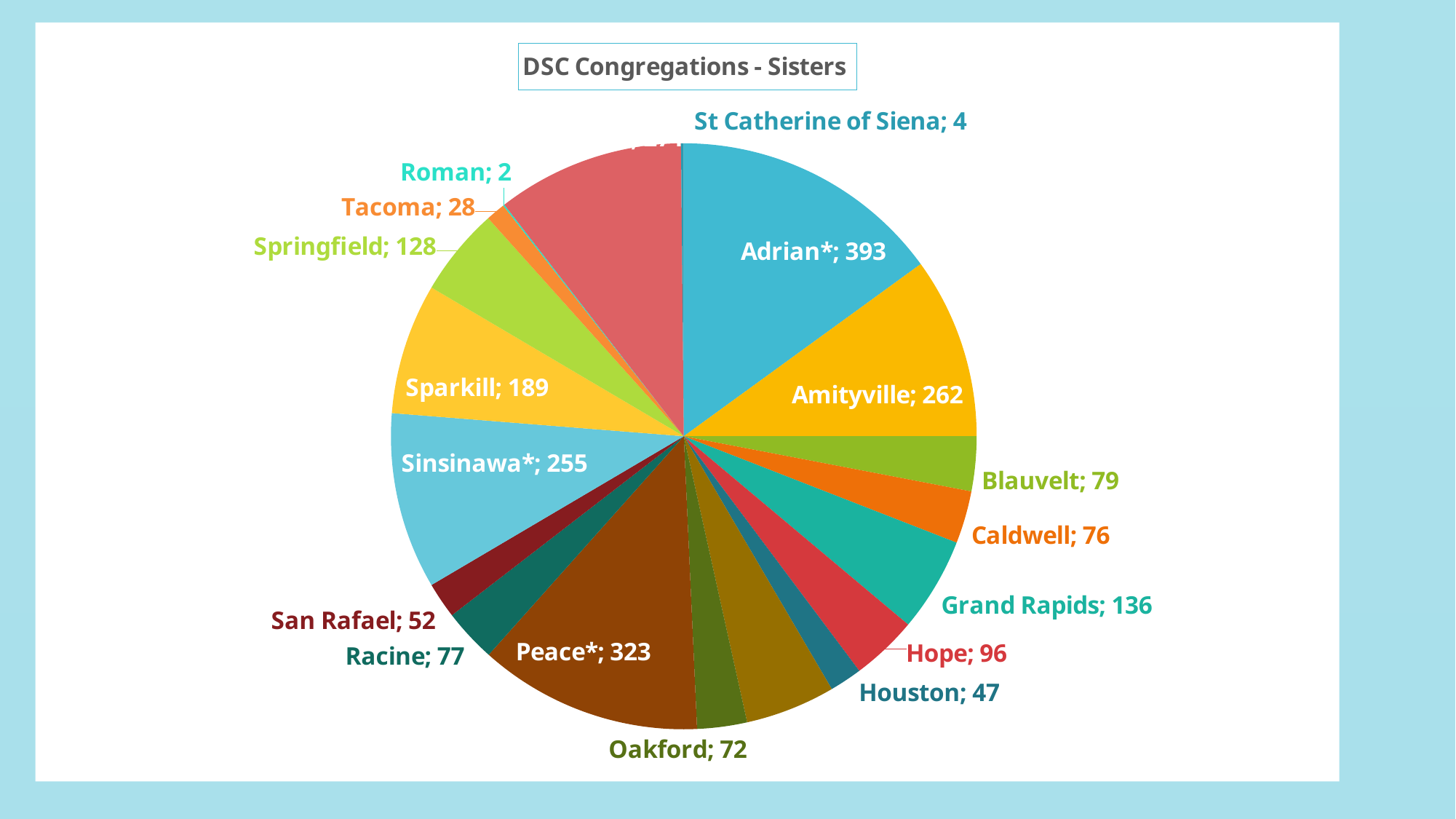
Which is larger, Hope or Houston? Hope What type of chart is shown on the slide? pie chart What is the value for St Catherine of Siena? 4 What is the difference between the values for Peace* and Amityville? 61 What is the value for Sinsinawa*? 255 Which congregation has the largest slice? Adrian* What is the title of the chart? DSC Congregations - Sisters Which is larger, Tacoma or San Rafael? San Rafael What is the difference between the values for Sparkill and Springfield? 61 Which congregation has the smallest slice? Roman What is the value for Adrian*? 393 What is the value for Grand Rapids? 136